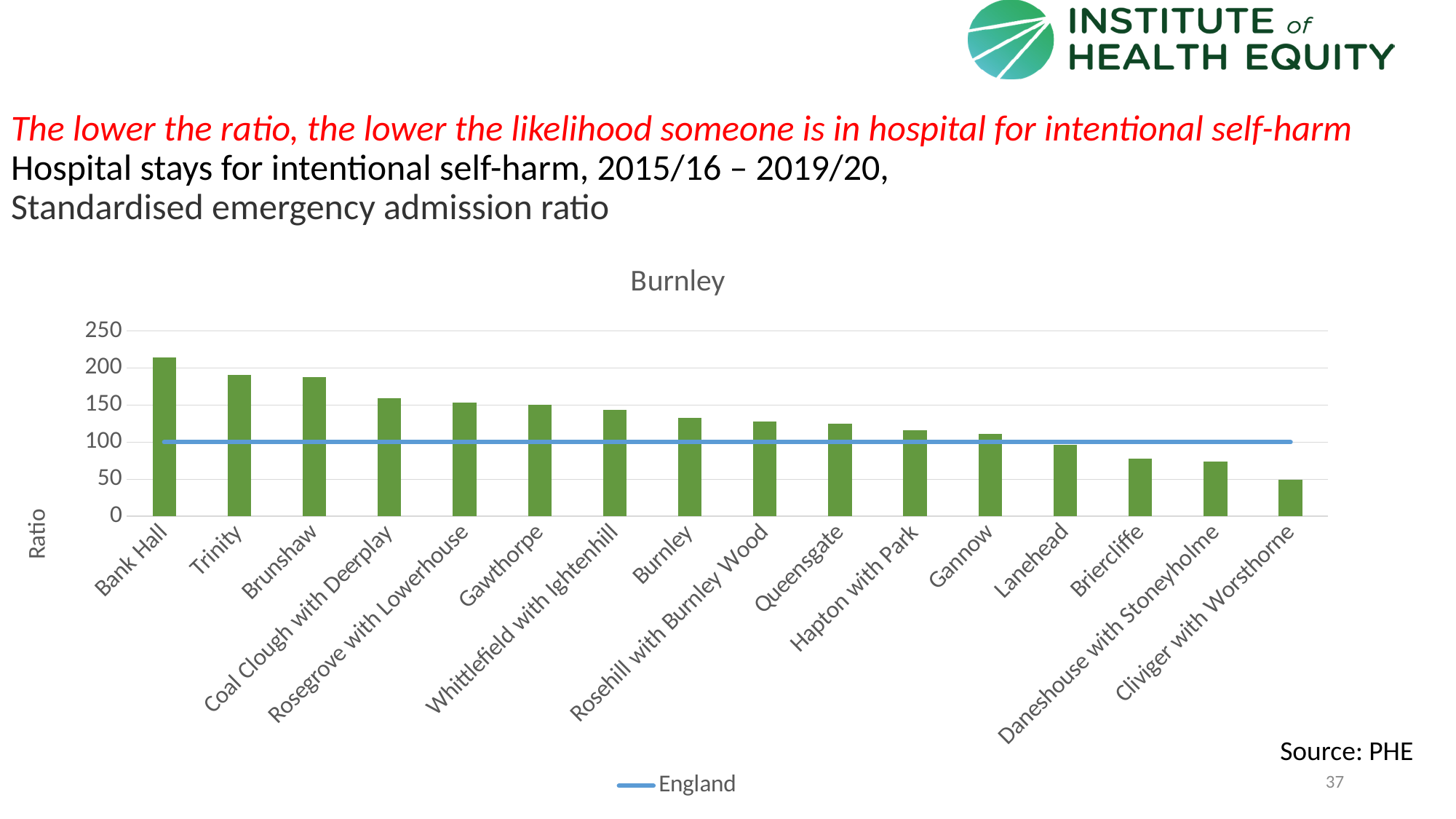
Is the value for Bank Hall greater or less than 200? greater Which has the larger ratio, Bank Hall or Gawthorpe? Bank Hall Which ward has the lowest ratio? Cliviger with Worsthorne What is the title of the chart? Burnley How many wards (categories) are plotted on the x axis? 16 Which ward has the highest ratio? Bank Hall Is the value for Briercliffe greater or less than 100? less Is the value for Trinity greater or less than 200? less What kind of chart is shown on the slide? bar chart Do the bar values rise or fall from left to right along the x axis? fall